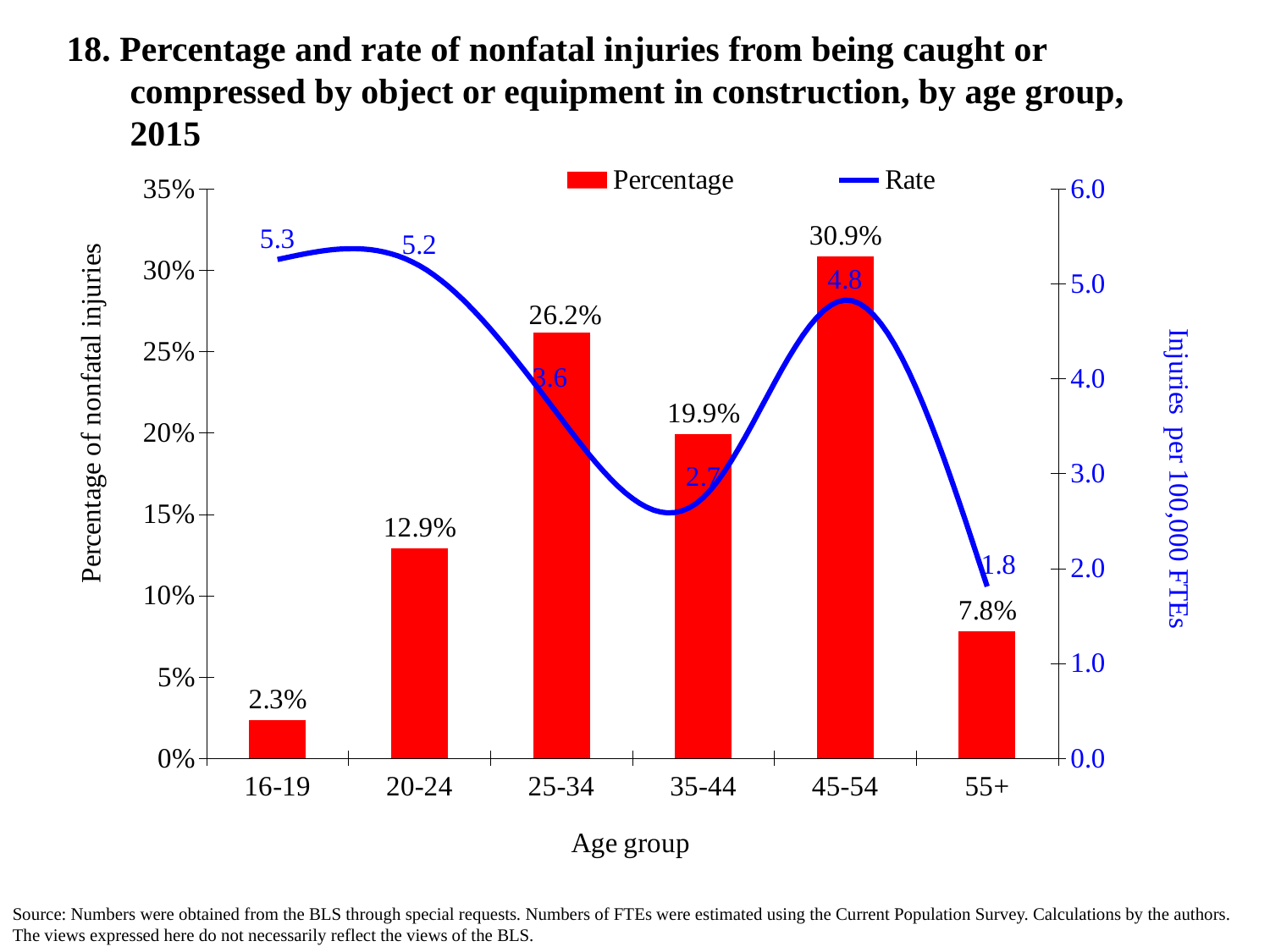
Which age group has the highest percentage of nonfatal injuries? 45-54 What is the label of the right-hand vertical axis? Injuries per 100,000 FTEs What kind of chart is used to show the Percentage series? Bar chart What percentage of nonfatal injuries is shown for the 55+ age group? 7.8% What is the injury rate per 100,000 FTEs for the 35-44 age group? 2.7 Which age group has a higher injury rate, 20-24 or 45-54? 20-24 What is the difference in percentage of nonfatal injuries between the 25-34 and 35-44 age groups? 6.3% Which age group has the lowest injury rate per 100,000 FTEs? 55+ What percentage of nonfatal injuries is shown for the 45-54 age group? 30.9% What is the injury rate per 100,000 FTEs for the 16-19 age group? 5.3 How many series does the legend list? 2 How many age groups are shown on the x axis? 6